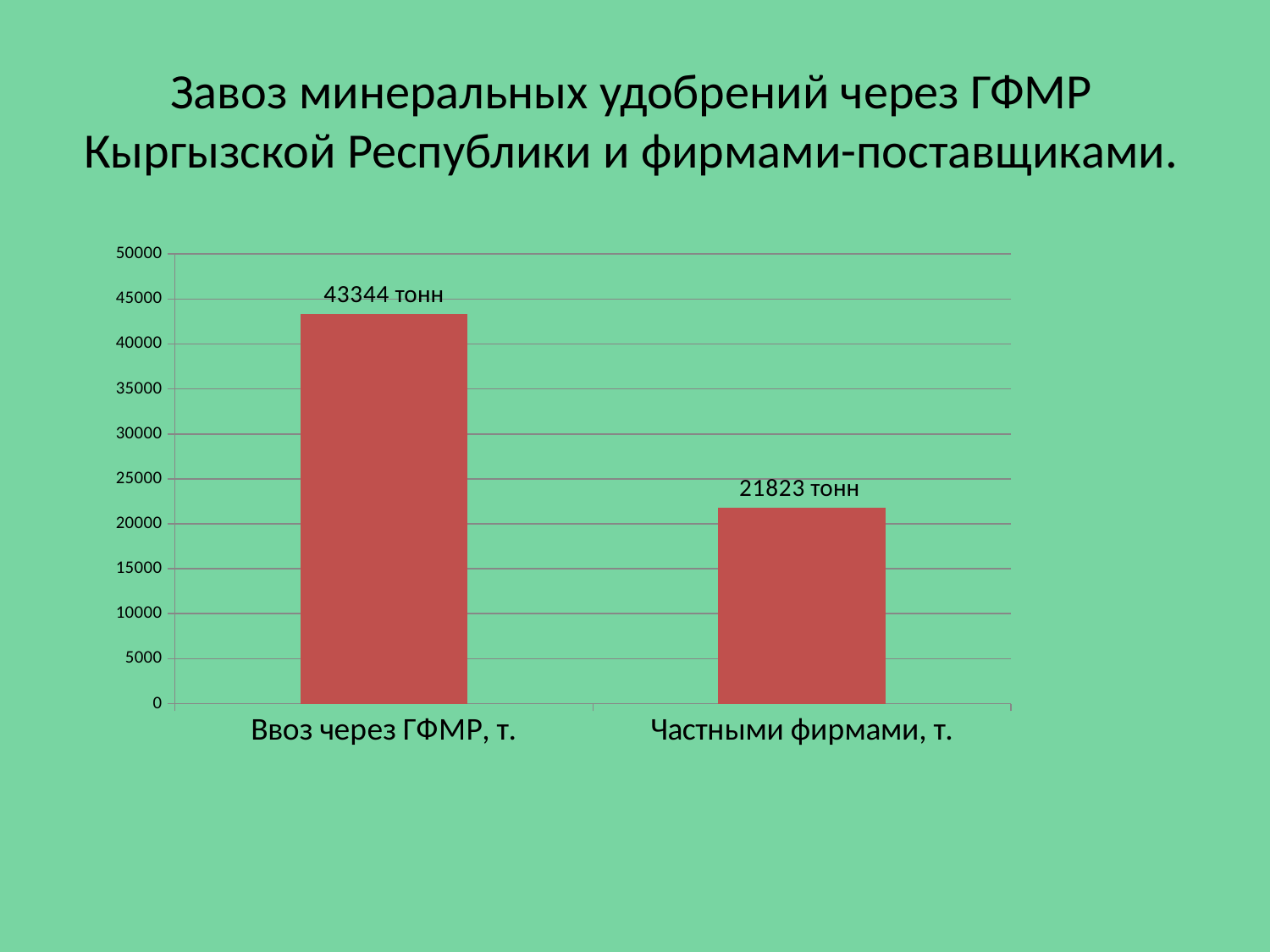
What is the difference between the value for "Ввоз через ГФМР, т." and the value for "Частными фирмами, т."? 21521 тонн What is the value for "Ввоз через ГФМР, т."? 43344 тонн What kind of chart is shown on the slide? bar chart How many categories are shown on the chart? 2 Is the value for "Частными фирмами, т." greater or less than 25000? less Which category has the lowest value? Частными фирмами, т. What is the title of the slide? Завоз минеральных удобрений через ГФМР Кыргызской Республики и фирмами-поставщиками. Which is larger: the value for "Ввоз через ГФМР, т." or the value for "Частными фирмами, т."? Ввоз через ГФМР, т. What is the total of the two values shown on the chart? 65167 тонн Which category has the highest value? Ввоз через ГФМР, т. What is the value for "Частными фирмами, т."? 21823 тонн Is the value for "Ввоз через ГФМР, т." greater or less than 40000? greater